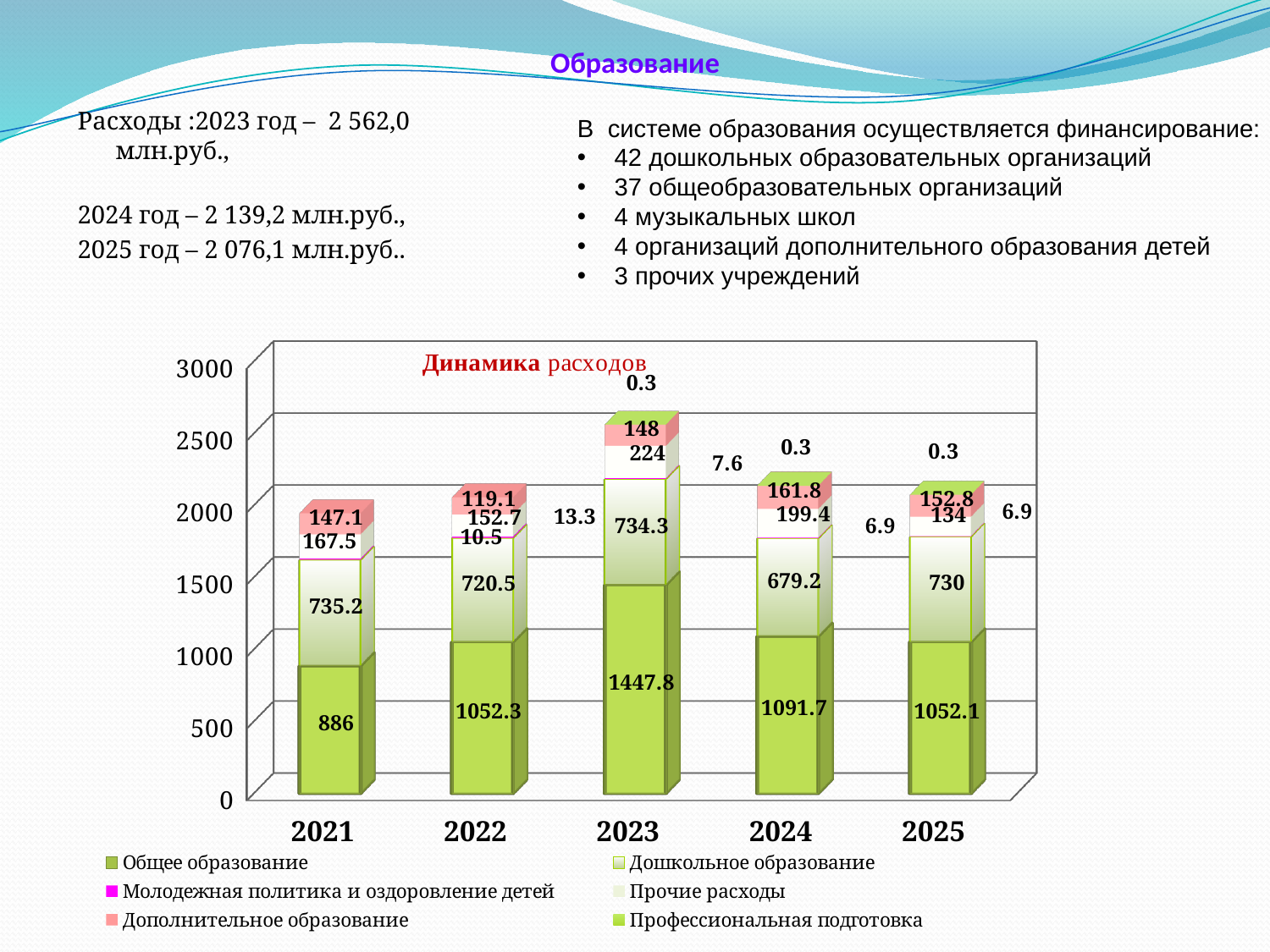
Which is larger, the Дошкольное образование value for 2021 or for 2022? 2021 What is the value for Дошкольное образование in 2025? 730 How many series does the chart legend list? 6 What kind of chart is shown on the slide? Stacked bar chart What is the title of the chart? Динамика расходов How many years are shown on the x axis of the chart? 5 What is the value for Общее образование in 2023? 1447.8 In which year is the value for Общее образование highest? 2023 What is the value for Общее образование in 2021? 886 What is the value for Дошкольное образование in 2024? 679.2 In which year is the value for Общее образование lowest? 2021 What is the difference between the Общее образование values for 2023 and 2021? 561.8